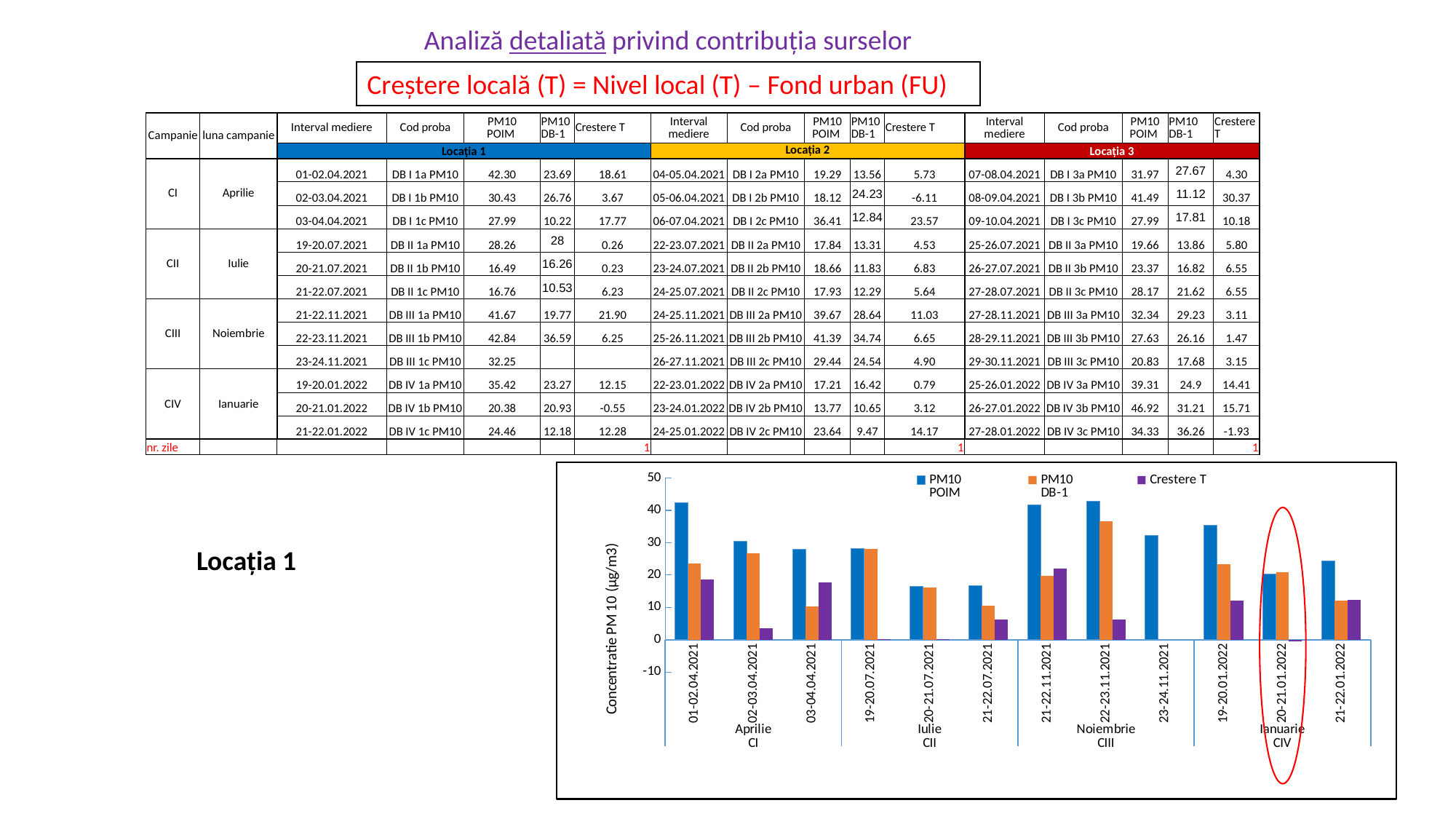
What kind of chart is shown on the slide? bar chart How many series does the chart legend list? 3 Which date has the highest Crestere T value in the chart? 21-22.11.2021 What is the title of the chart's vertical axis? Concentratie PM 10 (µg/m3) Is the PM10 POIM value for 20-21.07.2021 greater or less than 20? less How many date categories are plotted along the x axis of the chart? 12 Across the three April dates (01-02.04.2021 to 03-04.04.2021), do the PM10 POIM values rise or fall? fall Is the PM10 DB-1 value for 22-23.11.2021 greater or less than 30? greater Which date has the highest PM10 DB-1 value in the chart? 22-23.11.2021 Is the PM10 POIM value for 01-02.04.2021 greater or less than 40? greater For 19-20.01.2022, which is larger: PM10 POIM or PM10 DB-1? PM10 POIM